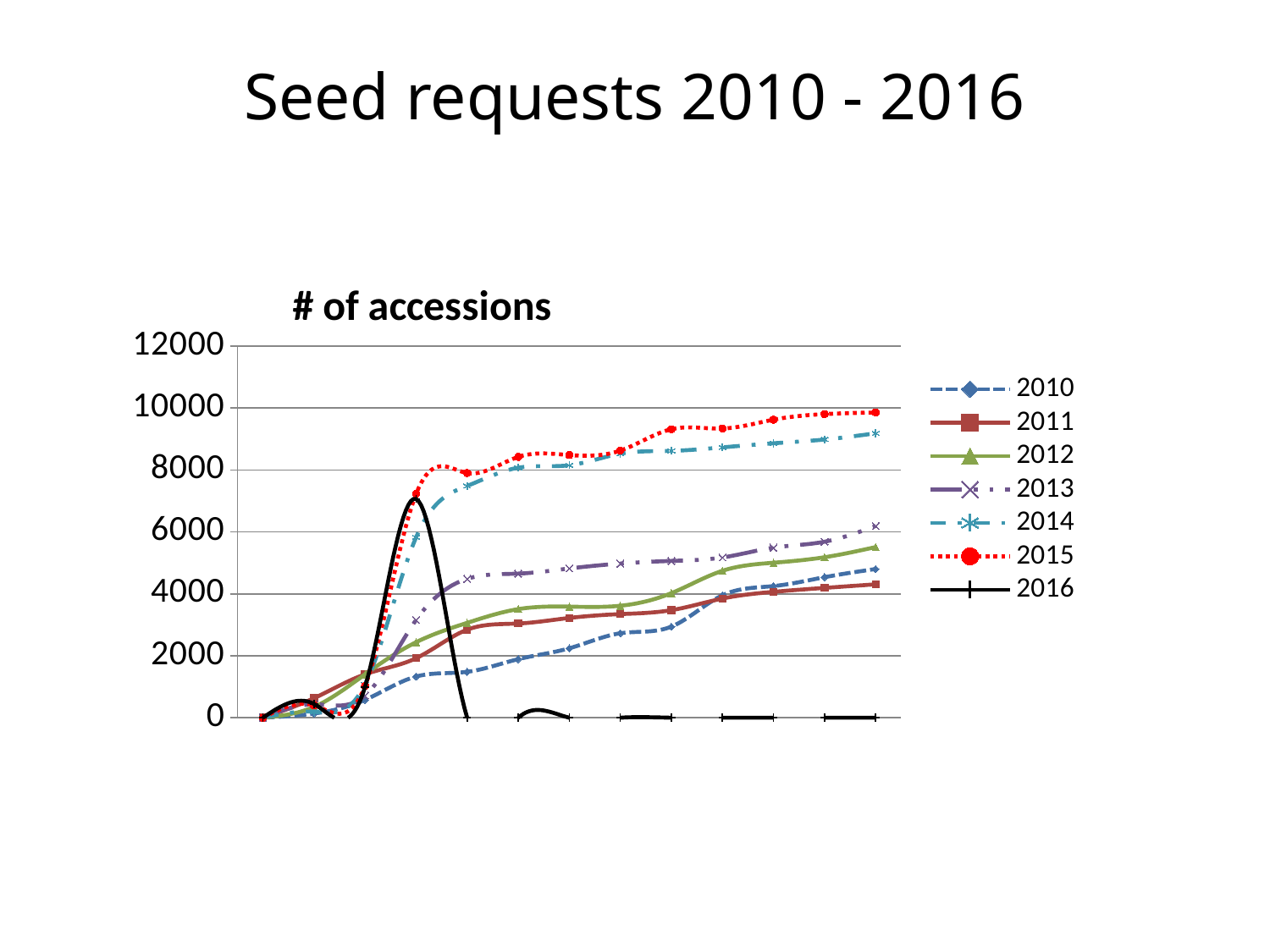
What is the title of the chart? # of accessions Is the final value of the 2015 series greater or less than 8000? greater What kind of chart is shown on the slide? line chart Is the final value of the 2013 series greater or less than 4000? greater At the right end of the chart, which is larger: the 2014 series or the 2012 series? 2014 Which series is plotted with a red dotted line? 2015 Is the final value of the 2014 series greater or less than 8000? greater Which series reaches the highest value at the right end of the chart? 2015 Which series has the lowest value at the right end of the chart? 2016 How many series does the legend list? 7 Does the 2015 series generally rise or fall from left to right? rise